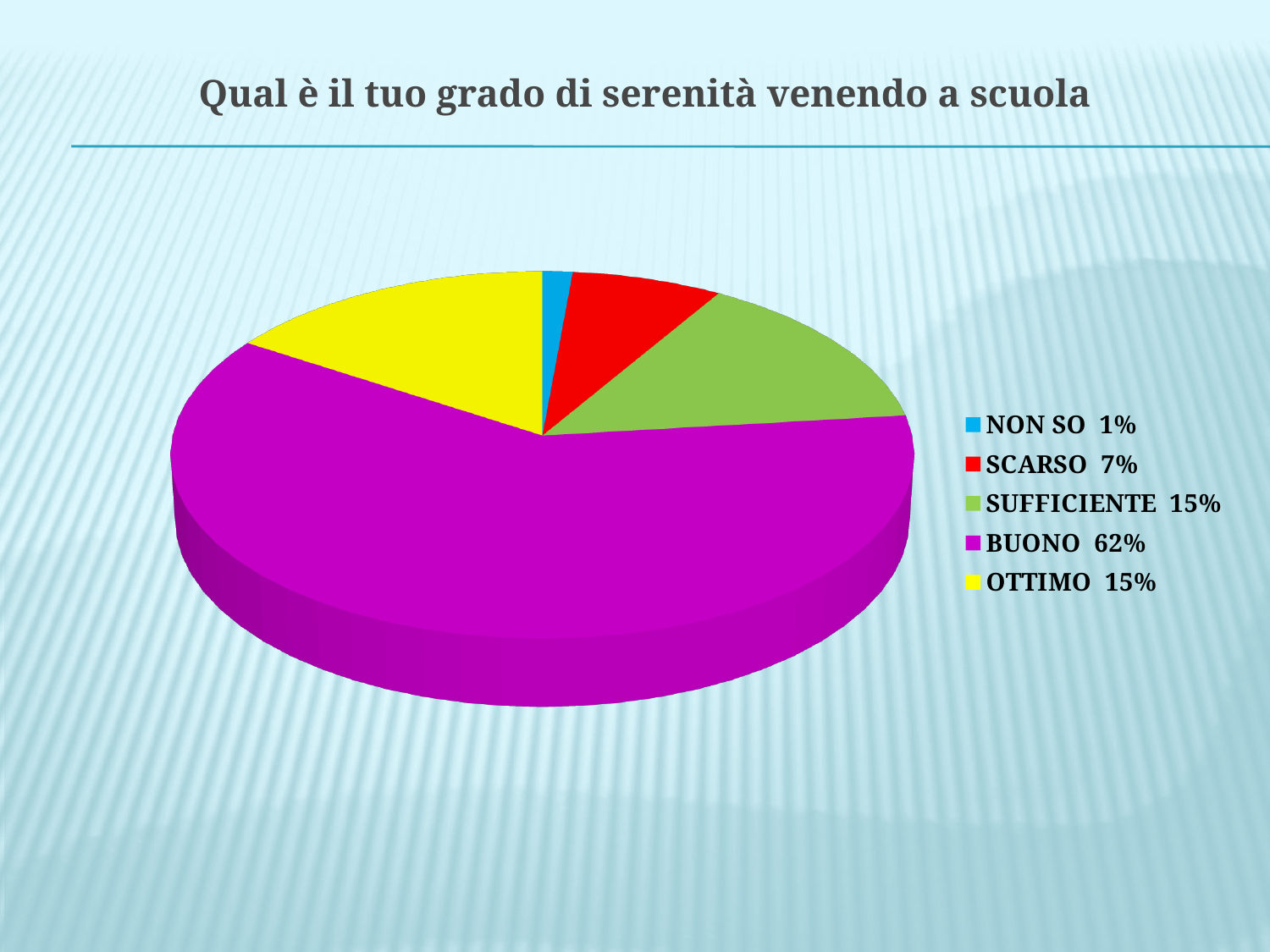
What kind of chart is shown on the slide? pie chart Which category has the largest share of the pie? BUONO Which is larger, SCARSO or SUFFICIENTE? SUFFICIENTE What percentage is shown for BUONO? 62% How many categories does the legend list? 5 What is the title of the chart? Qual è il tuo grado di serenità venendo a scuola What percentage is shown for SUFFICIENTE? 15% What colour is the BUONO slice? purple What is the difference in percentage points between BUONO and OTTIMO? 47 What percentage is shown for SCARSO? 7% Which category has the smallest share of the pie? NON SO What percentage is shown for NON SO? 1%